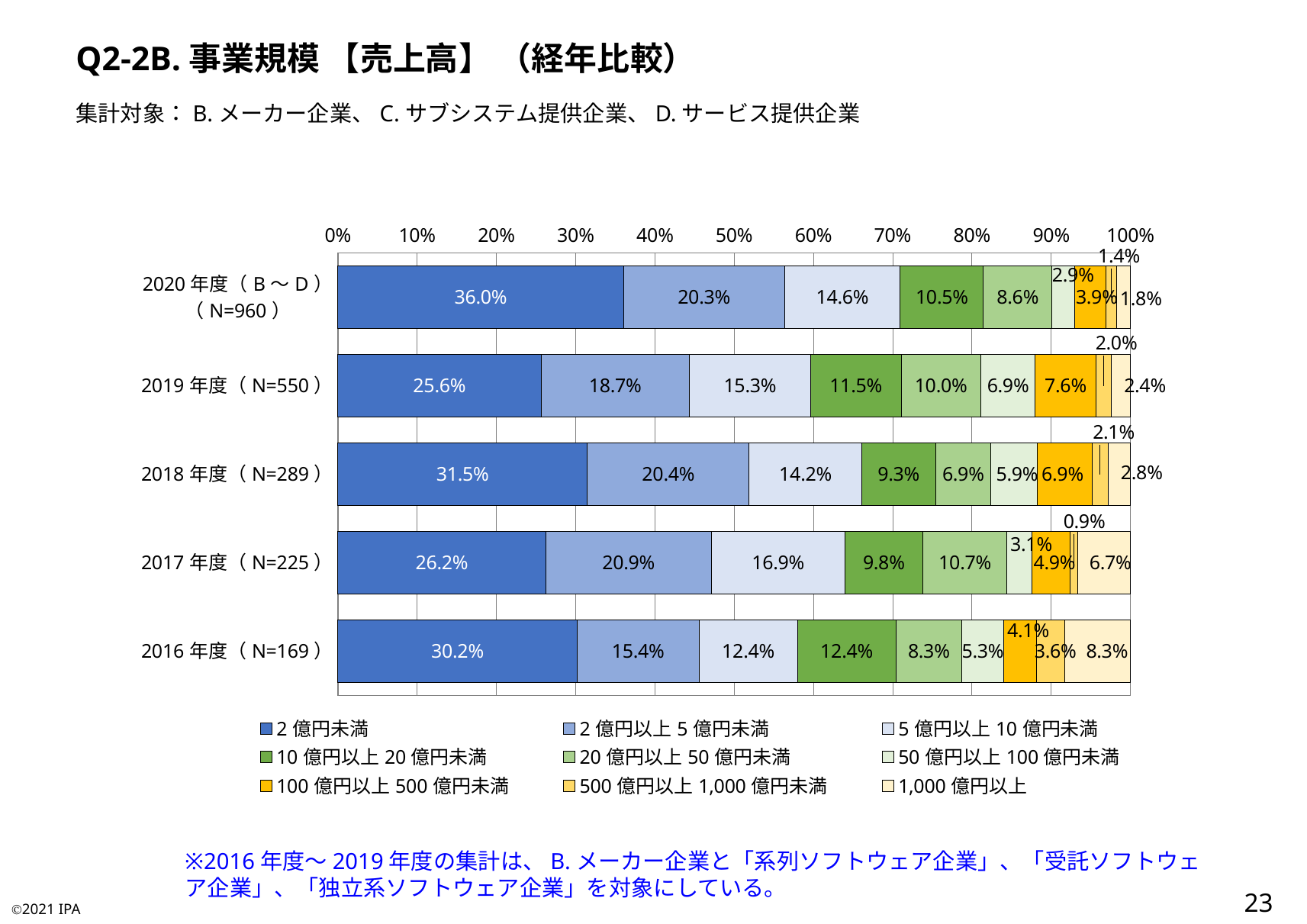
What kind of chart is shown on the slide? Stacked bar chart Which is larger: the 2億円以上5億円未満 value for 2018年度 or for 2016年度? 2018年度 How many years (bars) are shown in the chart? 5 How many series does the legend list? 9 What is the title of the slide? Q2-2B. 事業規模【売上高】（経年比較） What is the value for 2億円未満 in 2020年度（B～D）（N=960）? 36.0% What is the value for 5億円以上10億円未満 in 2017年度（N=225）? 16.9% What is the value for 2億円以上5億円未満 in 2019年度（N=550）? 18.7% What is the value for 10億円以上20億円未満 in 2016年度（N=169）? 12.4% Which year has the highest value for 2億円未満? 2020年度（B～D）（N=960） What is the difference between the 2億円未満 values for 2020年度 and 2019年度? 10.4 percentage points Which year has the lowest value for 2億円未満? 2019年度（N=550）